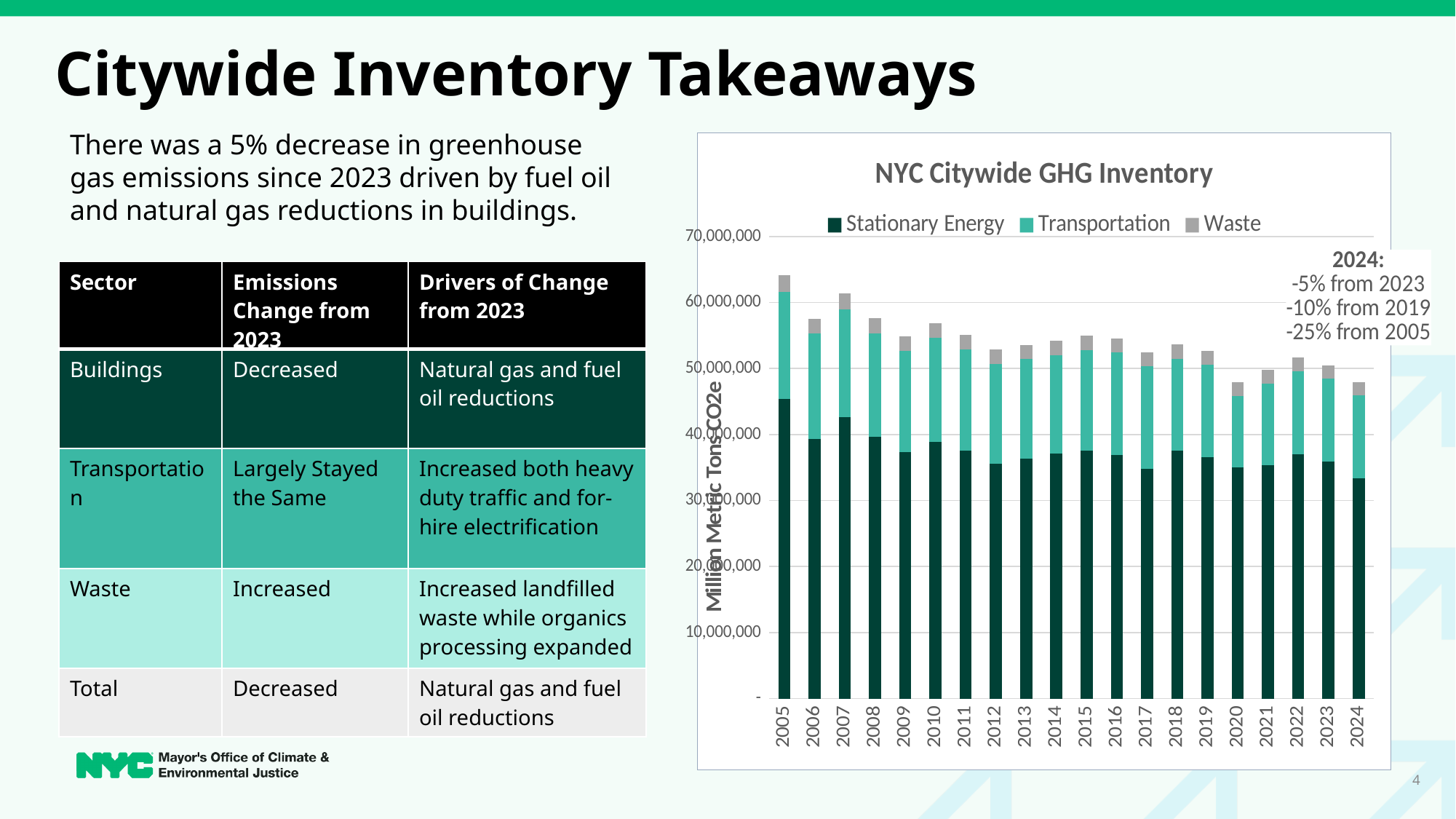
How many years are shown on the x axis of the NYC Citywide GHG Inventory chart? 20 Is the Stationary Energy value for 2005 in the NYC Citywide GHG Inventory chart greater or less than 40,000,000? greater Do total emissions in the NYC Citywide GHG Inventory chart generally rise or fall from 2005 to 2024? Fall Which series are listed in the legend of the NYC Citywide GHG Inventory chart? Stationary Energy, Transportation, Waste Is the total emissions value for 2005 in the NYC Citywide GHG Inventory chart greater or less than 60,000,000? greater Is the Stationary Energy value for 2024 in the NYC Citywide GHG Inventory chart greater or less than 40,000,000? less Which year has the highest total emissions in the NYC Citywide GHG Inventory chart? 2005 How many series does the legend of the NYC Citywide GHG Inventory chart list? 3 What kind of chart is the NYC Citywide GHG Inventory chart? Stacked bar chart What is the first year shown on the x axis of the NYC Citywide GHG Inventory chart? 2005 In the NYC Citywide GHG Inventory chart, which year has the larger total emissions, 2005 or 2024? 2005